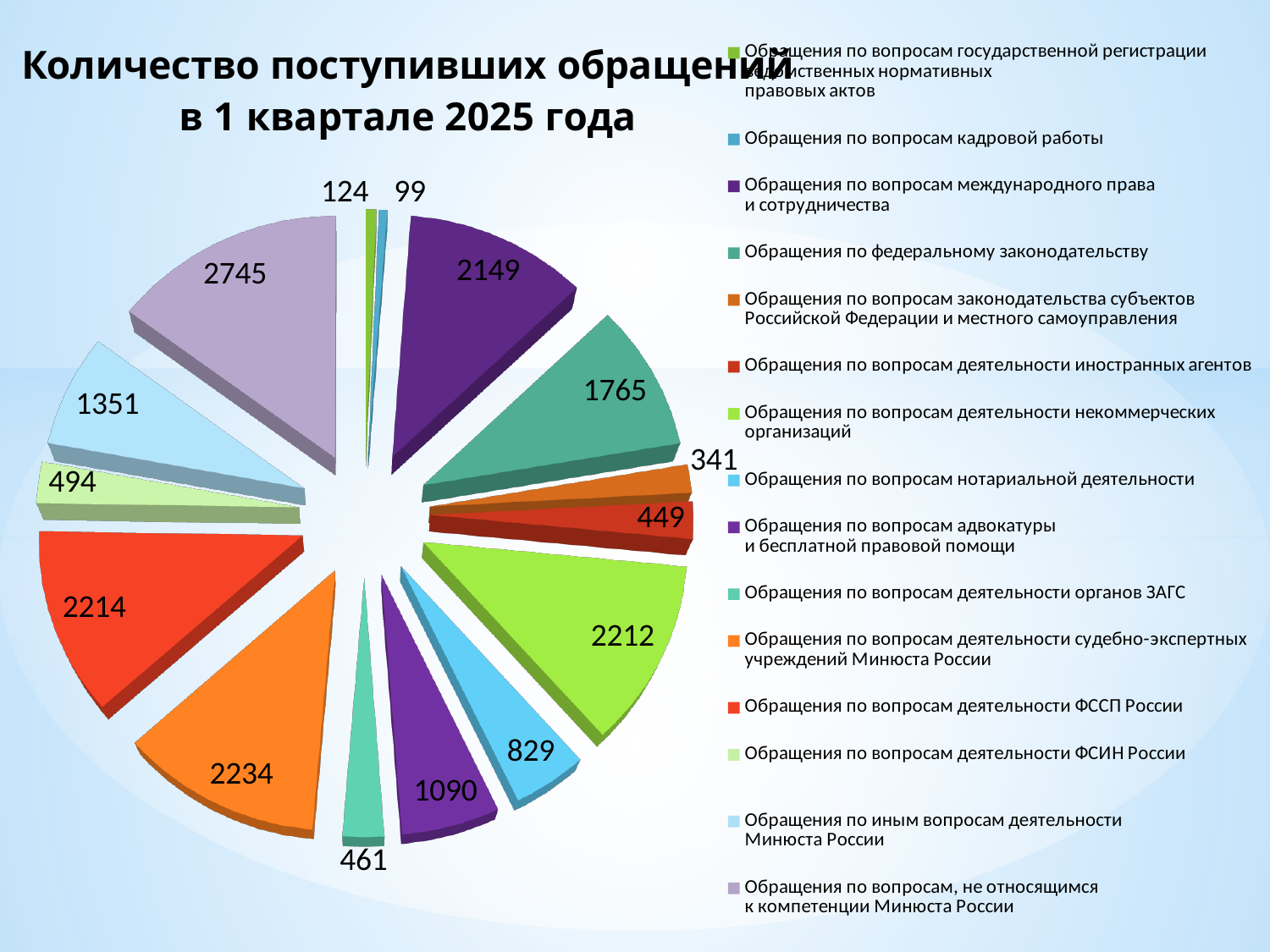
What type of chart is shown on the slide? Pie chart What is the value for 'Обращения по вопросам нотариальной деятельности'? 829 What is the difference between the values for 'Обращения по вопросам деятельности судебно-экспертных учреждений Минюста России' and 'Обращения по вопросам деятельности ФССП России'? 20 What is the value for 'Обращения по вопросам деятельности ФССП России'? 2214 Which category has the lowest value? Обращения по вопросам кадровой работы How many slices does the pie chart have? 15 What is the value for 'Обращения по вопросам деятельности органов ЗАГС'? 461 What is the difference between the values for 'Обращения по вопросам, не относящимся к компетенции Минюста России' and 'Обращения по вопросам международного права и сотрудничества'? 596 What is the title of the chart? Количество поступивших обращений в 1 квартале 2025 года What is the value for 'Обращения по вопросам международного права и сотрудничества'? 2149 Which is larger: the value for 'Обращения по федеральному законодательству' or the value for 'Обращения по иным вопросам деятельности Минюста России'? Обращения по федеральному законодательству Which category has the highest value? Обращения по вопросам, не относящимся к компетенции Минюста России